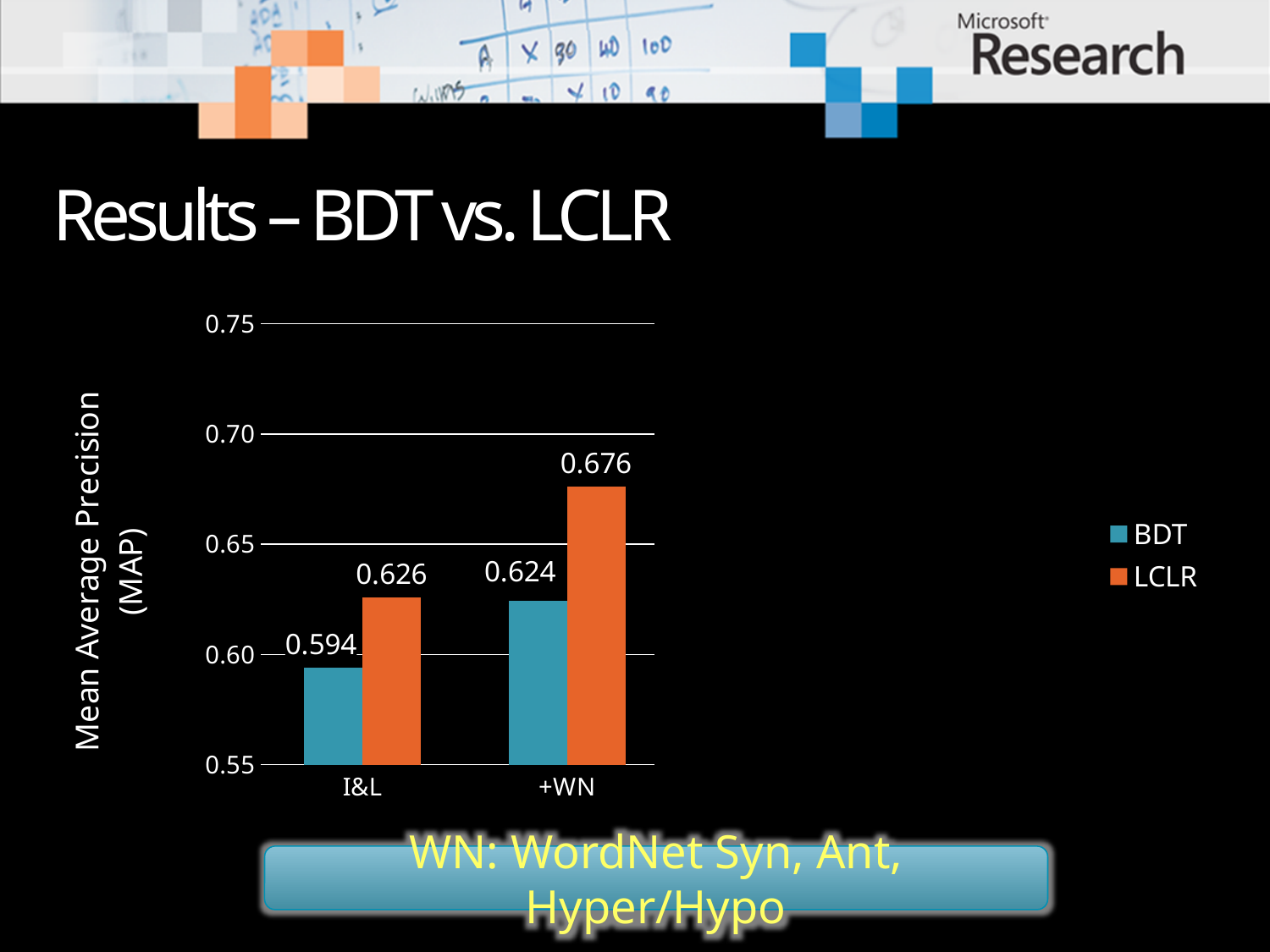
What is the MAP value for BDT on +WN? 0.624 What is the MAP value for LCLR on +WN? 0.676 What is the difference between the LCLR and BDT values on I&L? 0.032 Which is larger: BDT on +WN or LCLR on I&L? LCLR on I&L What is the MAP value for LCLR on I&L? 0.626 What is the difference between the LCLR and BDT values on +WN? 0.052 What is the label of the y axis? Mean Average Precision (MAP) What kind of chart is shown on the slide? Bar chart Which bar has the highest MAP value in the chart? LCLR on +WN Which bar has the lowest MAP value in the chart? BDT on I&L How many series does the legend list? 2 What is the MAP value for BDT on I&L? 0.594